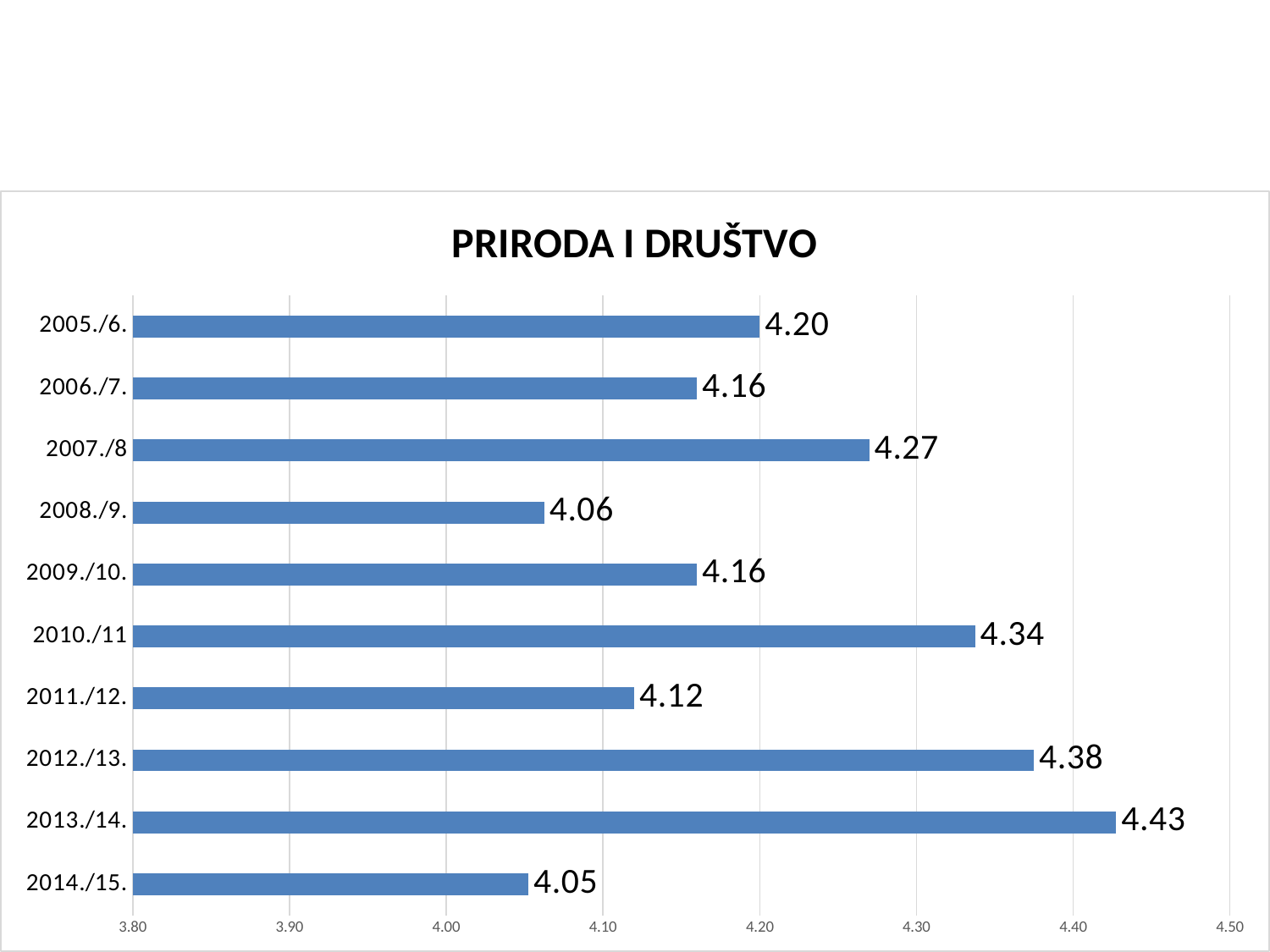
Which is larger, the value for 2007./8 or the value for 2011./12.? 2007./8 Which school year has the lowest value? 2014./15. What is the value for 2008./9.? 4.06 What is the difference between the values for 2013./14. and 2014./15.? 0.38 What kind of chart is this? bar chart Which school year has the highest value? 2013./14. What is the difference between the values for 2005./6. and 2006./7.? 0.04 What is the value for 2013./14.? 4.43 How many school years are shown in the chart? 10 Is the value for 2012./13. greater or less than 4.30? greater What is the title of the chart? PRIRODA I DRUŠTVO What is the value for 2010./11? 4.34